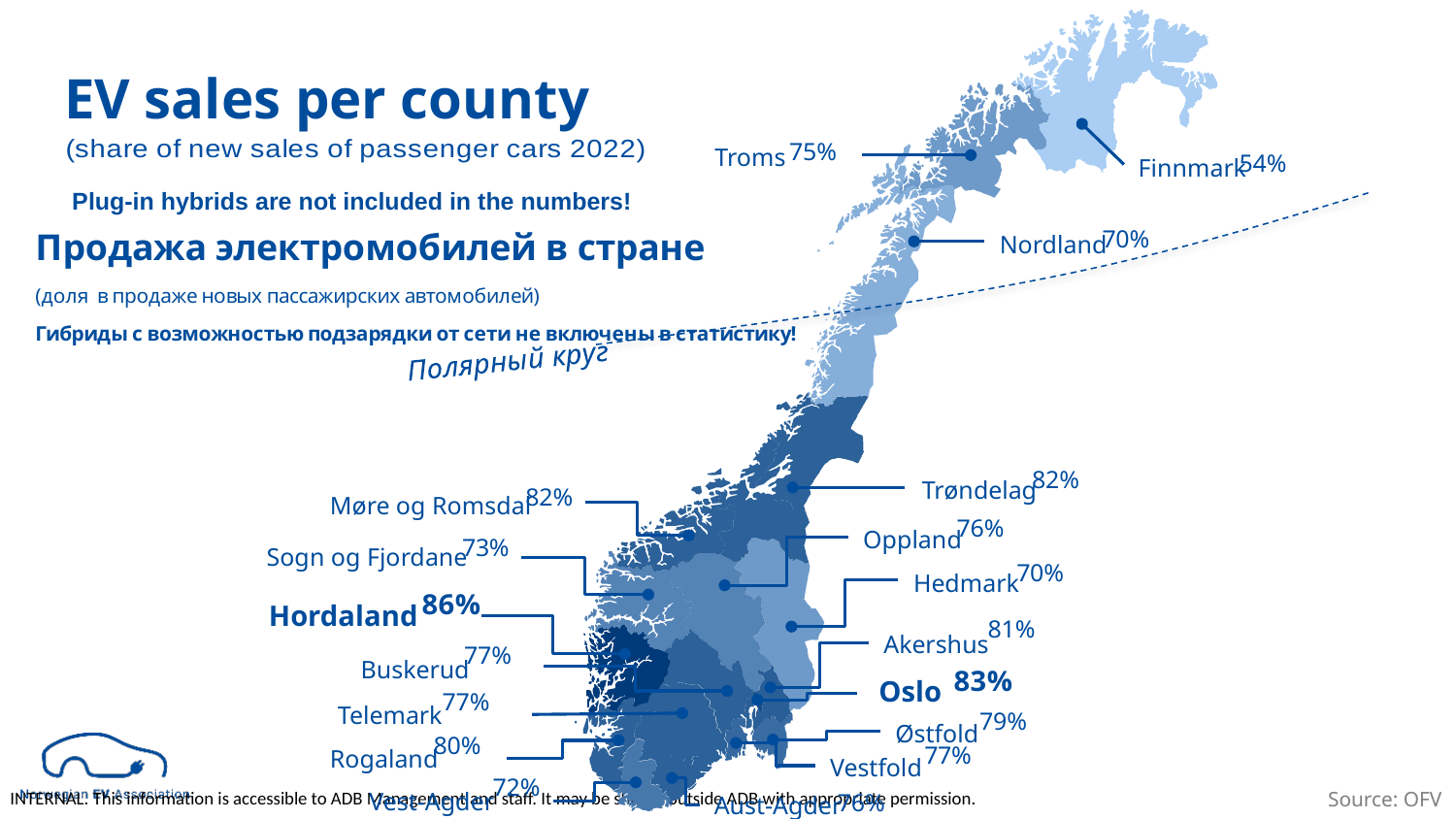
Which county has the lowest EV sales share? Finnmark Which has a higher EV sales share, Troms or Nordland? Troms What is the EV sales share for Rogaland? 80% What is the EV sales share for Nordland? 70% What kind of chart is shown on the slide? Map chart What is the source cited for the data on the slide? OFV What is the difference in EV sales share between Hordaland and Finnmark? 32 percentage points Which county has the highest EV sales share? Hordaland What is the EV sales share for Oslo? 83% What is the EV sales share for Finnmark? 54% What is the EV sales share for Hordaland? 86% What is the difference in EV sales share between Oslo and Akershus? 2 percentage points